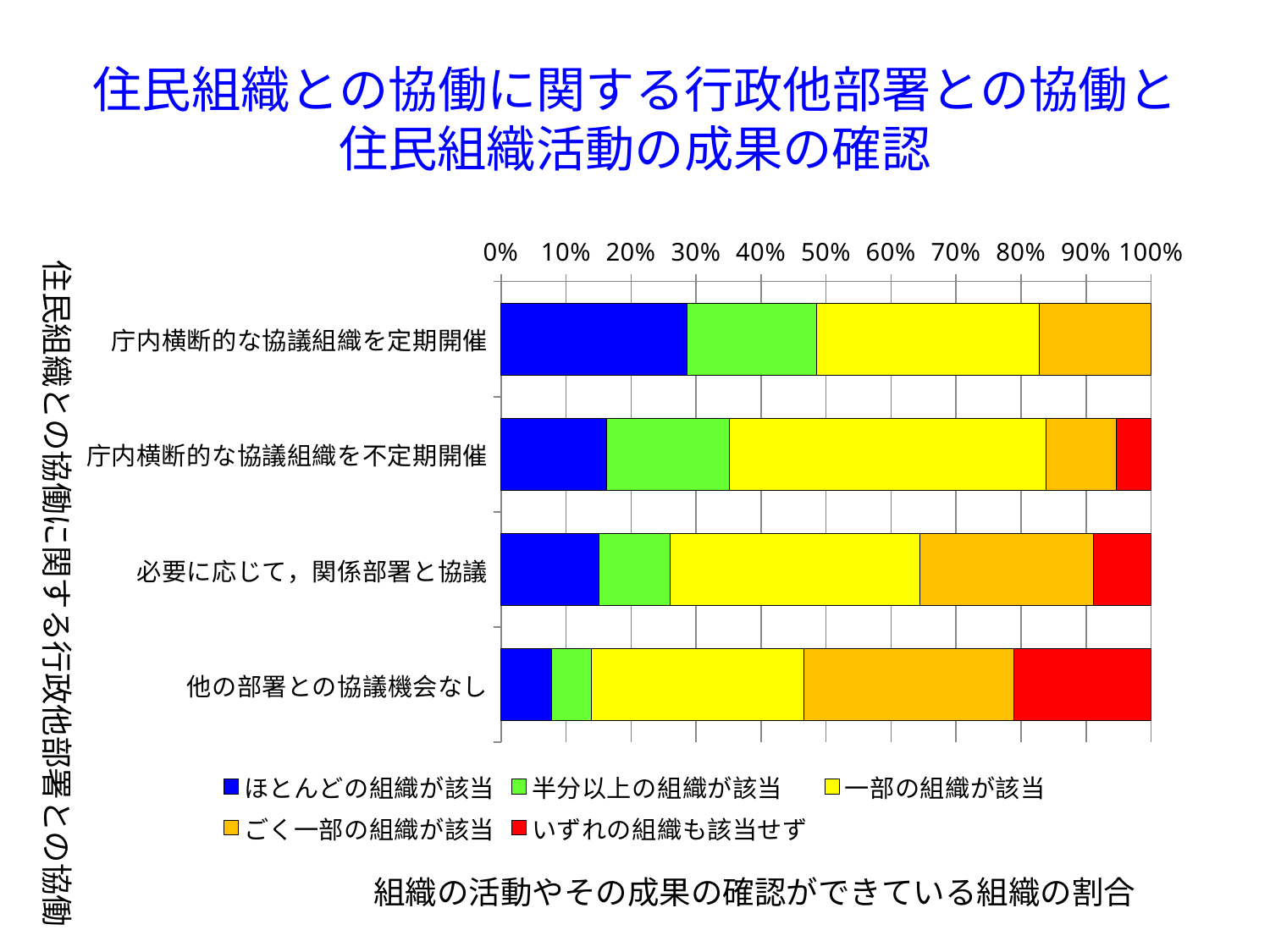
What kind of chart is shown on the slide? Stacked bar chart Which category has a larger share of 一部の組織が該当 (yellow): 庁内横断的な協議組織を定期開催 or 庁内横断的な協議組織を不定期開催? 庁内横断的な協議組織を不定期開催 How many series does the legend list? 5 Is the share of ほとんどの組織が該当 for 他の部署との協議機会なし greater or less than 20%? less What colour represents いずれの組織も該当せず in the legend? Red Which category has the largest share of いずれの組織も該当せず (red)? 他の部署との協議機会なし Going from the top category to the bottom category, does the share of ほとんどの組織が該当 (blue) increase or decrease? decrease How many categories are plotted on the vertical axis of the chart? 4 Which category has the largest share of ほとんどの組織が該当 (blue)? 庁内横断的な協議組織を定期開催 Which category has the smallest share of ほとんどの組織が該当 (blue)? 他の部署との協議機会なし Is the share of ほとんどの組織が該当 for 庁内横断的な協議組織を定期開催 greater or less than 20%? greater Which category has a larger share of 半分以上の組織が該当 (green): 庁内横断的な協議組織を定期開催 or 必要に応じて，関係部署と協議? 庁内横断的な協議組織を定期開催